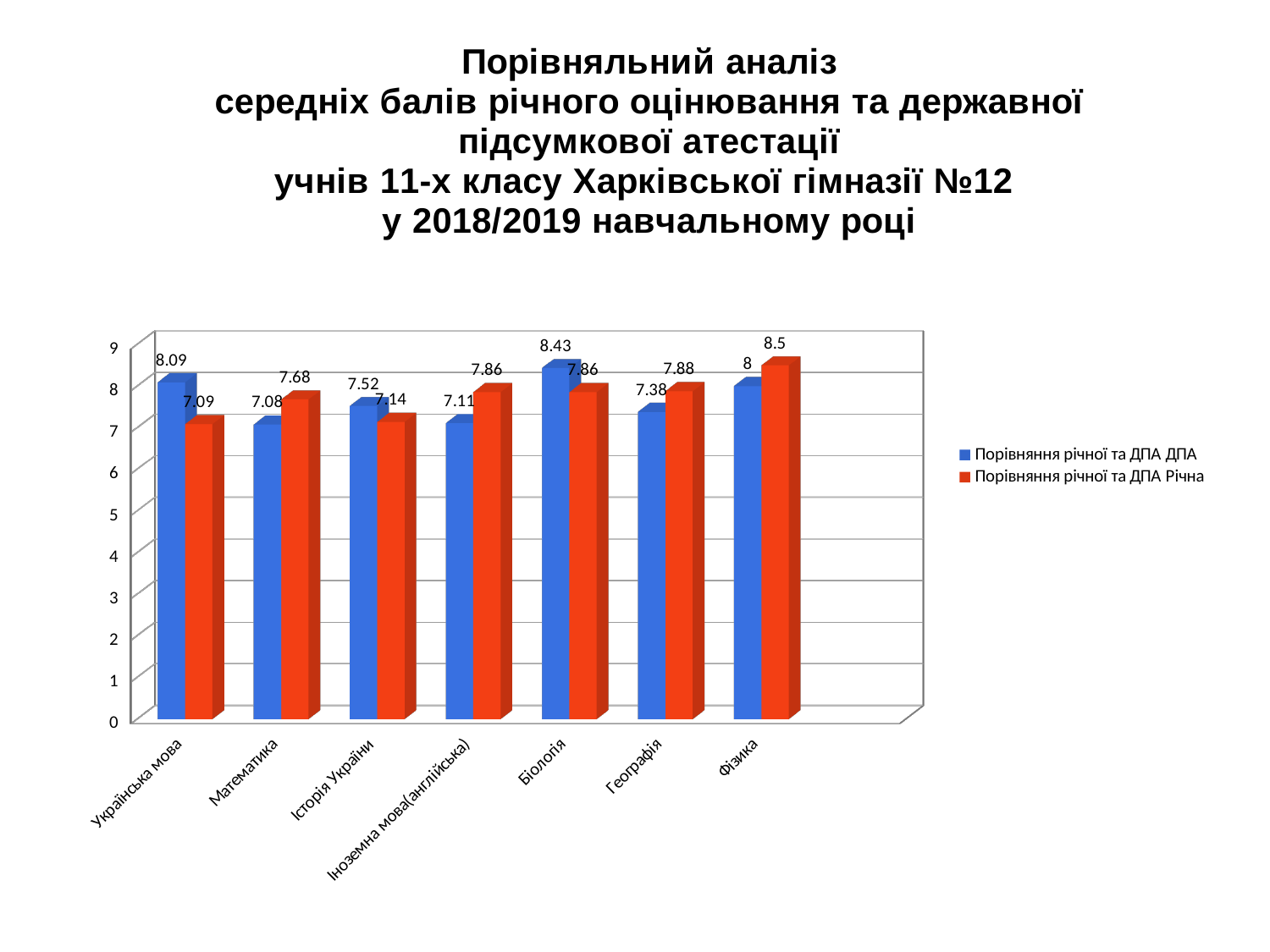
What kind of chart is shown on the slide? Bar chart Which is larger for Географія, the ДПА value or the Річна value? Річна What colour are the bars for the series 'Порівняння річної та ДПА Річна'? Red How many subjects are shown on the x axis? 7 What is the ДПА value for Математика? 7.08 Which subject has the lowest Річна value? Українська мова What is the Річна value for Фізика? 8.5 What is the Річна value for Українська мова? 7.09 Which subject has the highest ДПА value? Біологія How many series does the legend list? 2 What is the ДПА value for Біологія? 8.43 What is the difference between the ДПА and Річна values for Українська мова? 1